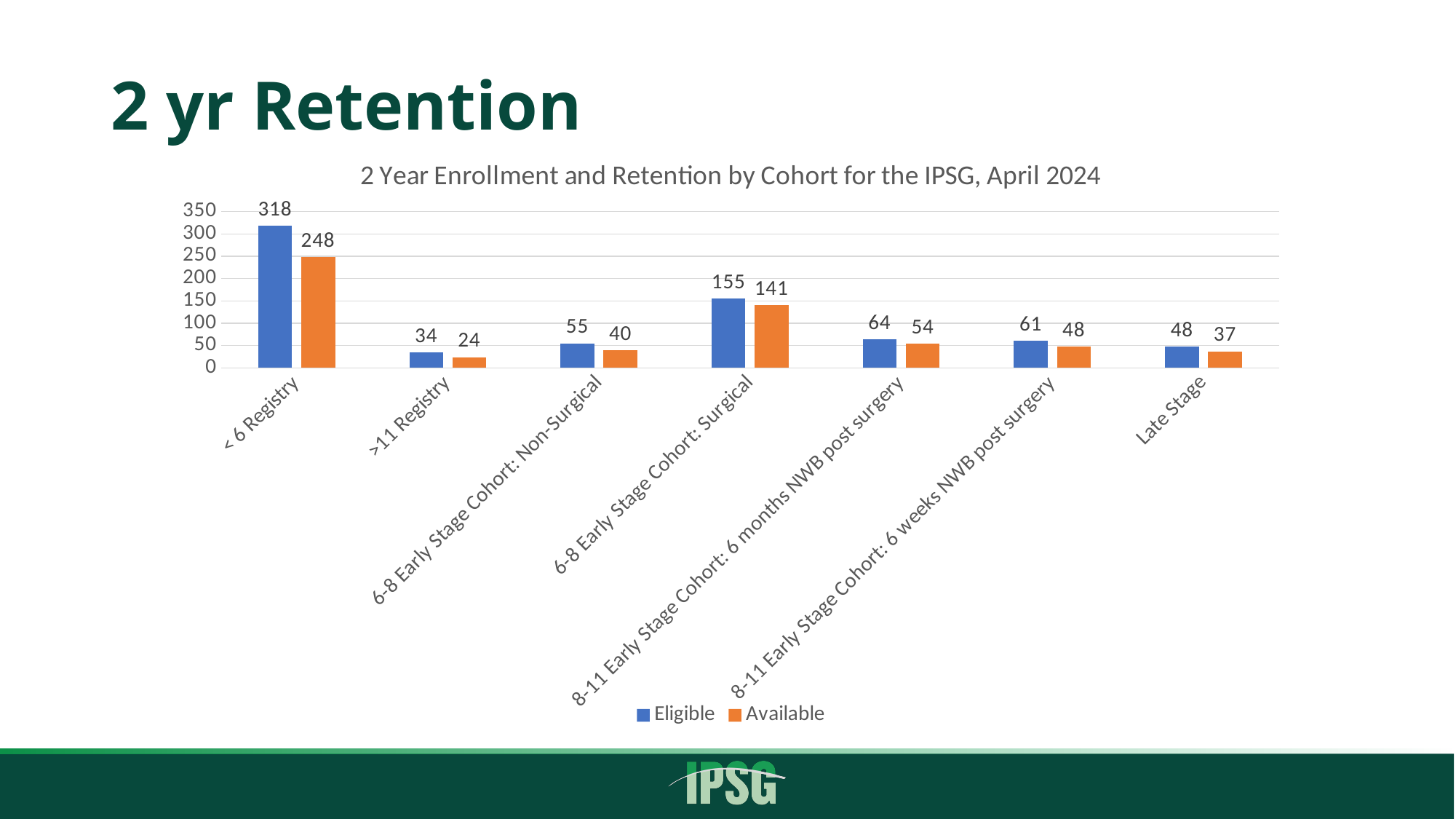
What is the difference between Eligible and Available for the 6-8 Early Stage Cohort: Non-Surgical? 15 What kind of chart is shown on the slide? Bar chart How many series does the legend list? 2 Which cohort has the highest Eligible value? < 6 Registry What is the title of the chart? 2 Year Enrollment and Retention by Cohort for the IPSG, April 2024 What is the Eligible value for the < 6 Registry cohort? 318 What is the Available value for Late Stage? 37 Which is larger, the Eligible value for 8-11 Early Stage Cohort: 6 months NWB post surgery or the Eligible value for 8-11 Early Stage Cohort: 6 weeks NWB post surgery? 8-11 Early Stage Cohort: 6 months NWB post surgery Which cohort has the lowest Available value? >11 Registry What is the Available value for the 6-8 Early Stage Cohort: Surgical? 141 What is the difference between Eligible and Available for the < 6 Registry cohort? 70 How many cohorts are shown on the x axis? 7